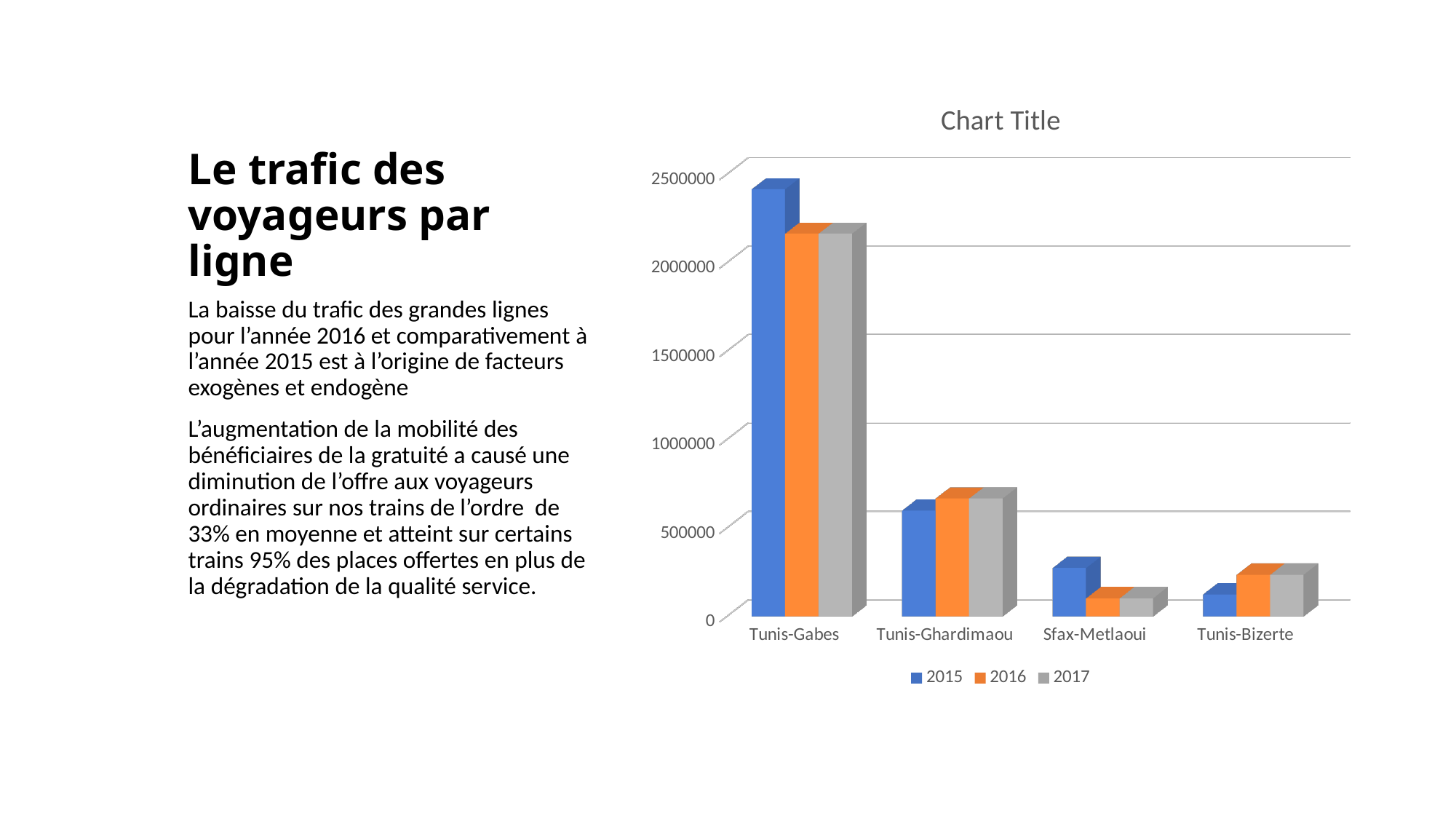
Which line has the lowest value for 2015? Tunis-Bizerte Is the 2015 value for Sfax-Metlaoui greater or less than 500000? less How many series does the chart legend list? 3 How many categories (lines) are shown on the x axis of the chart? 4 For Tunis-Bizerte, which is larger: the 2015 value or the 2016 value? 2016 For Sfax-Metlaoui, which is larger: the 2015 value or the 2016 value? 2015 For Tunis-Gabes, did the value rise or fall from 2015 to 2016? fall What kind of chart is shown on the slide? bar chart Is the 2016 value for Tunis-Ghardimaou greater or less than 1000000? less Is the 2015 value for Tunis-Gabes greater or less than 2000000? greater Which line has the highest value for 2015? Tunis-Gabes What title is displayed above the chart? Chart Title